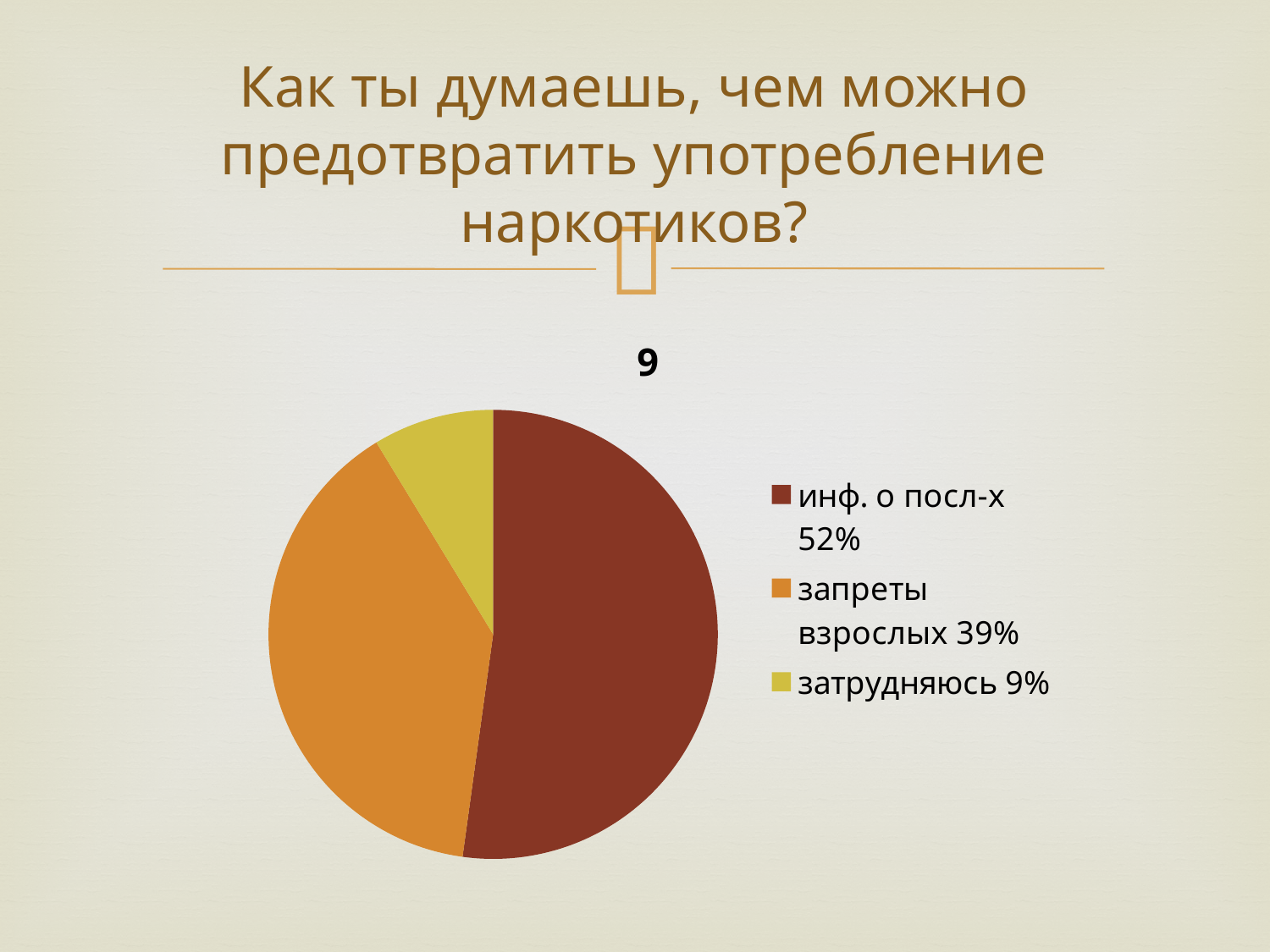
Which category has the smallest slice of the pie? затрудняюсь Which is larger, the share for "запреты взрослых" or the share for "затрудняюсь"? запреты взрослых What is the chart title shown above the pie? 9 What share of the pie is labelled "инф. о посл-х"? 52% What share of the pie is labelled "затрудняюсь"? 9% What is the difference in percentage points between "инф. о посл-х" and "запреты взрослых"? 13 Which category has the largest slice of the pie? инф. о посл-х What colour is the slice for "затрудняюсь"? yellow What share of the pie is labelled "запреты взрослых"? 39% What kind of chart is shown on the slide? pie chart What is the difference in percentage points between "запреты взрослых" and "затрудняюсь"? 30 How many slices does the pie chart have? 3